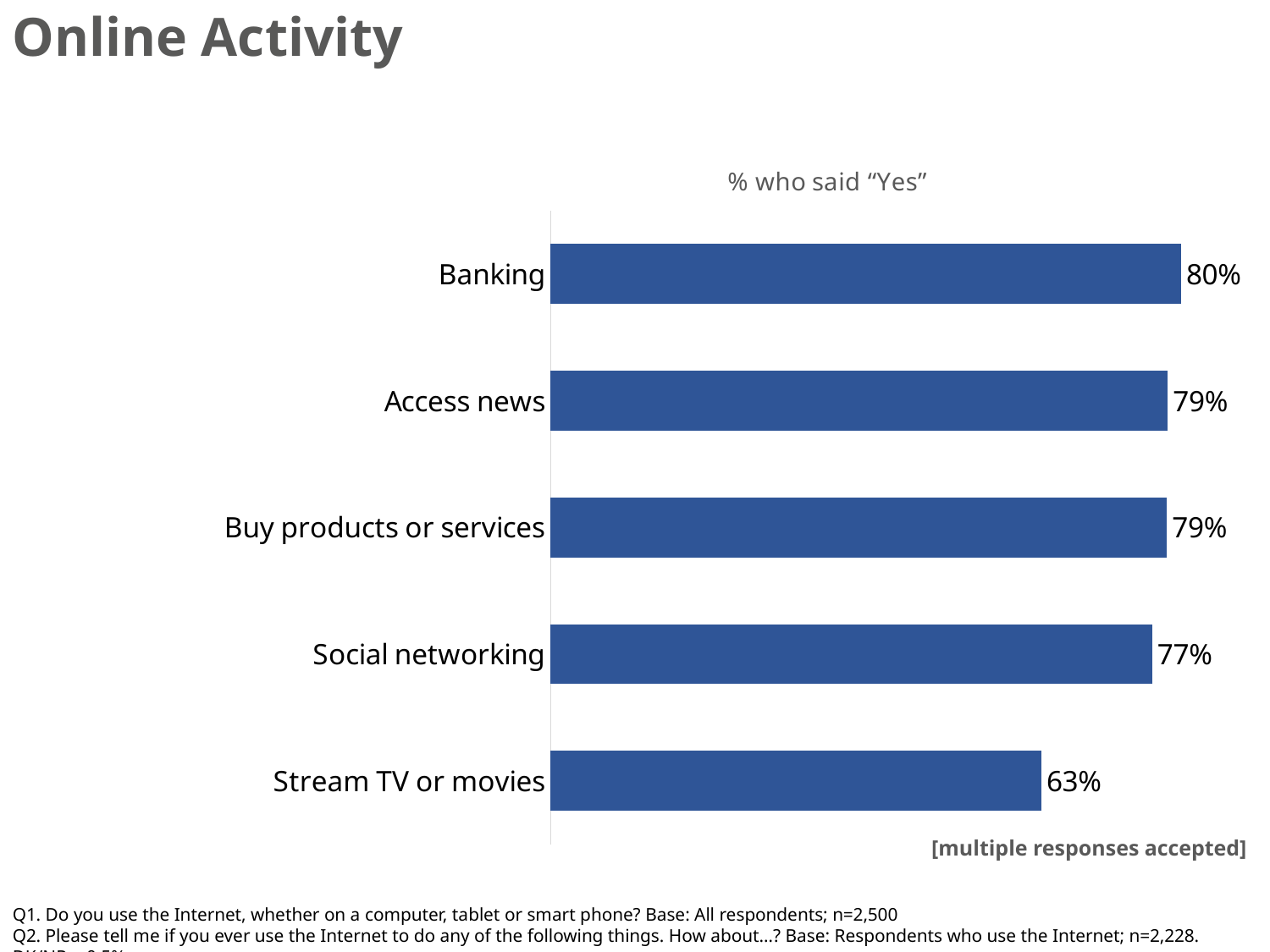
What is the subtitle shown above the chart? % who said "Yes" What percentage said "Yes" to Social networking? 77% What is the value for Stream TV or movies? 63% What is the difference in percentage points between Access news and Social networking? 2 What is the value for Access news? 79% Which is larger, the value for Social networking or the value for Stream TV or movies? Social networking What is the difference in percentage points between Banking and Stream TV or movies? 17 Which online activity has the lowest percentage of "Yes" responses? Stream TV or movies Which online activity has the highest percentage of "Yes" responses? Banking How many online activities are shown in the chart? 5 What type of chart is shown on the slide? Bar chart What percentage of respondents said "Yes" to Banking? 80%